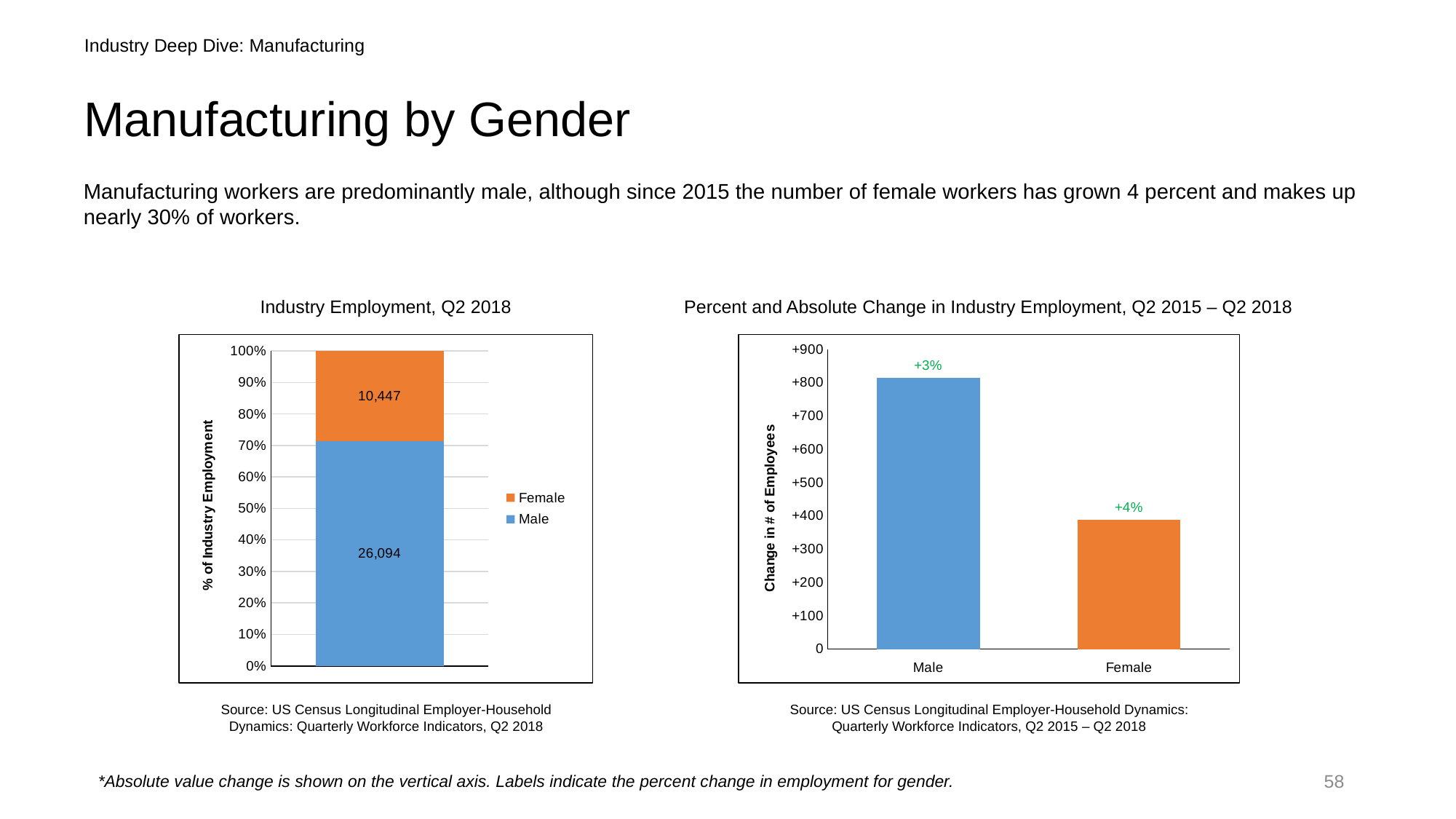
In the 'Percent and Absolute Change in Industry Employment, Q2 2015 – Q2 2018' chart, is the bar for Male greater or less than +700? greater In the 'Industry Employment, Q2 2018' chart, what is the difference between the Male and Female values? 15,647 What kind of chart is the 'Industry Employment, Q2 2018' chart? Stacked bar chart In the 'Industry Employment, Q2 2018' chart, what is the value shown for Female? 10,447 How many series does the legend of the 'Industry Employment, Q2 2018' chart list? 2 In the 'Percent and Absolute Change in Industry Employment, Q2 2015 – Q2 2018' chart, is the bar for Female greater or less than +500? less In the 'Industry Employment, Q2 2018' chart, what is the value shown for Male? 26,094 In the 'Industry Employment, Q2 2018' chart, which series has the larger value, Male or Female? Male In the 'Percent and Absolute Change in Industry Employment, Q2 2015 – Q2 2018' chart, which category has the taller bar? Male In the 'Percent and Absolute Change in Industry Employment, Q2 2015 – Q2 2018' chart, what percent change label is shown for Female? +4% In the 'Industry Employment, Q2 2018' chart, what is the total of the stacked bar? 36,541 In the 'Percent and Absolute Change in Industry Employment, Q2 2015 – Q2 2018' chart, what percent change label is shown for Male? +3%